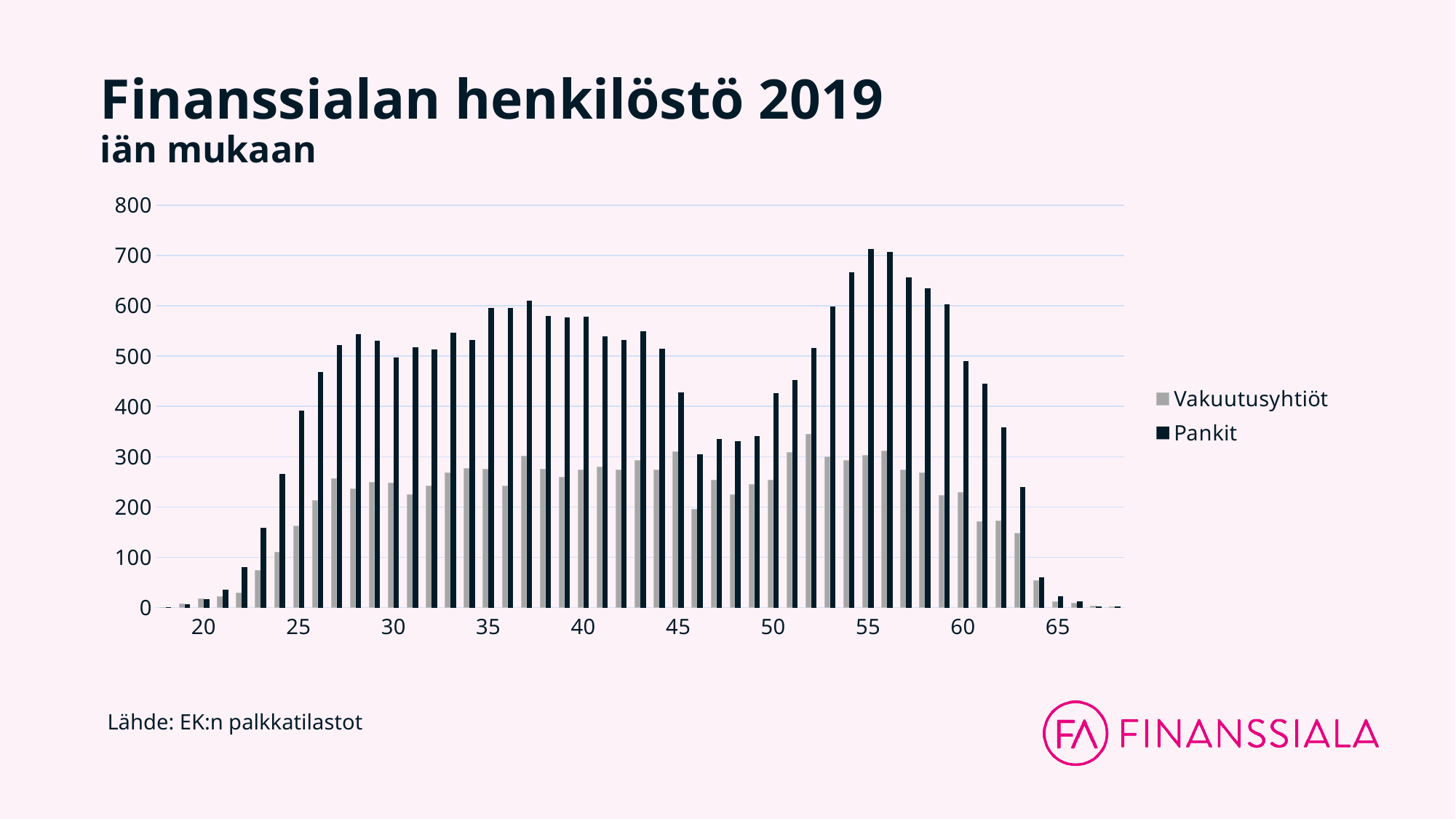
Is the value for Pankit at age 25 greater or less than 300? greater What is the title of the chart? Finanssialan henkilöstö 2019 Is the value for Pankit at age 45 greater or less than 500? less How many series does the legend list? 2 Is the value for Pankit at age 55 greater or less than 600? greater Which is larger for Pankit: the value at age 30 or the value at age 55? age 55 What kind of chart is shown on the slide? bar chart Which two series are listed in the legend? Vakuutusyhtiöt and Pankit Do the Pankit values rise or fall from age 60 to age 65? fall At age 40, which series has the larger value, Vakuutusyhtiöt or Pankit? Pankit